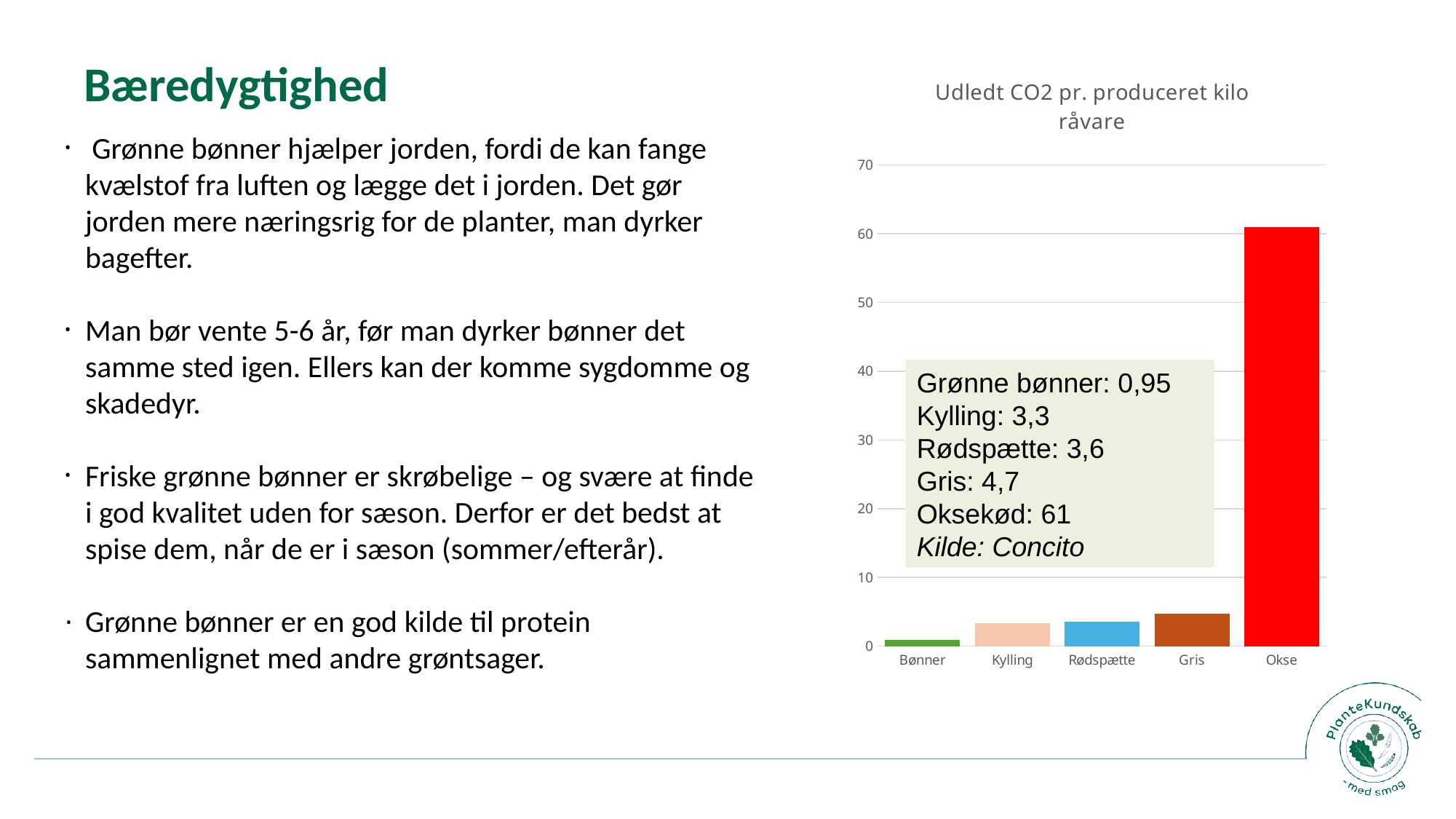
What kind of chart is shown on the slide? bar chart According to the values printed on the slide, what is the CO2 value for Gris? 4,7 Which has a larger value, Gris or Kylling? Gris Which category has the highest value in the chart? Okse According to the values printed on the slide, what is the CO2 value for Kylling? 3,3 Which category has the lowest value in the chart? Bønner Using the values printed on the slide, what is the difference between Oksekød and Gris? 56,3 What is the title of the chart? Udledt CO2 pr. produceret kilo råvare How many categories are shown on the x axis of the chart? 5 Is the value for Okse greater or less than 50? greater Is the value for Gris greater or less than 10? less According to the values printed on the slide, what is the CO2 value for Oksekød? 61